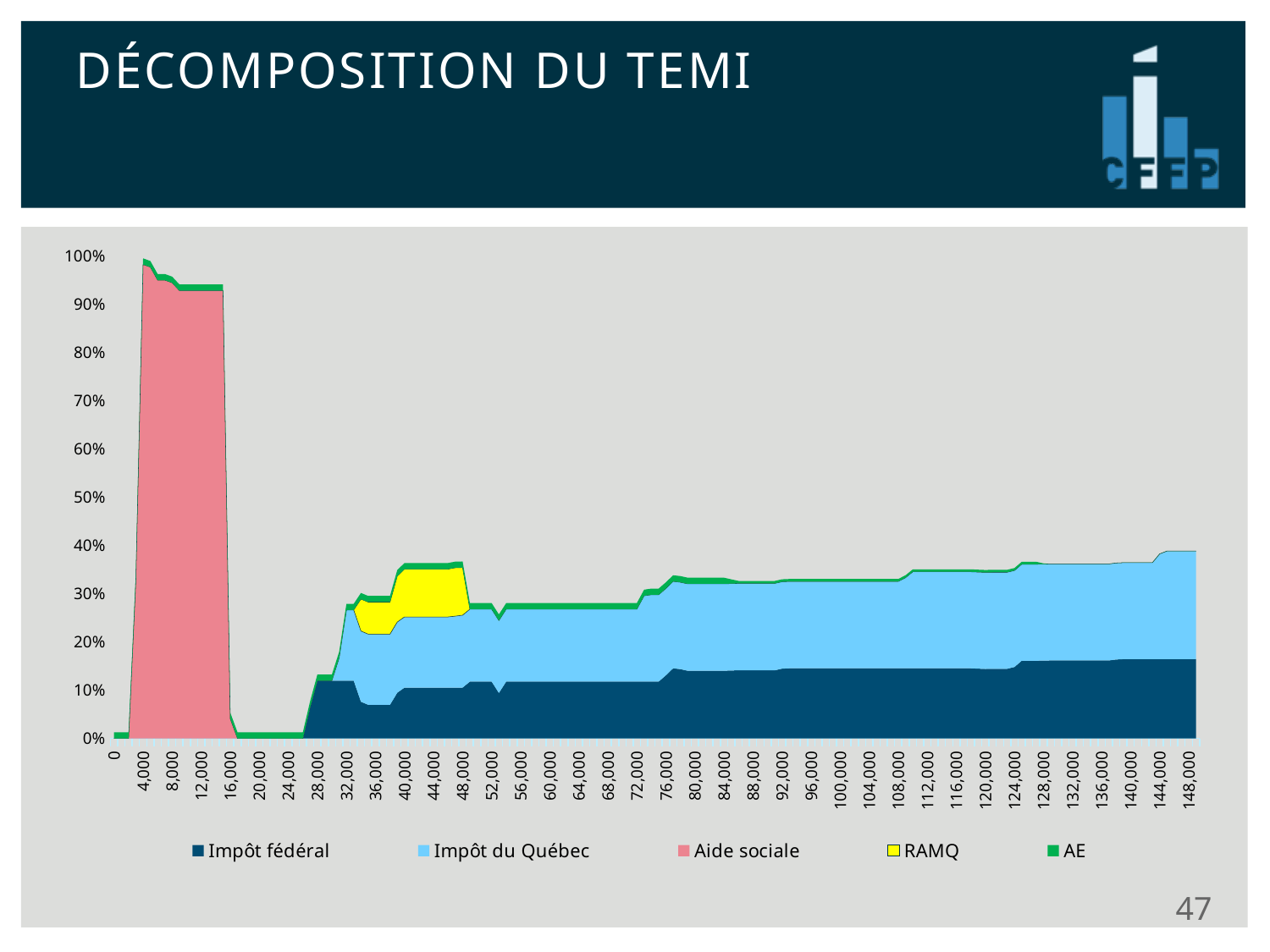
Which series is shown in yellow in the legend? RAMQ Is the total stacked value larger at 8,000 or at 80,000? 8,000 Is the total stacked value at 8,000 greater or less than 90%? greater How many series does the legend list? 5 Does the total stacked value rise or fall along the x axis from 76,000 to 148,000? rise What is the highest value shown on the y axis? 100% Is the total stacked value at 148,000 greater or less than 50%? less Is the total stacked value at 100,000 greater or less than 30%? greater What kind of chart is shown on the slide? stacked area chart Which series accounts for almost all of the stacked value between 4,000 and 16,000? Aide sociale What is the title of the slide containing the chart? DÉCOMPOSITION DU TEMI